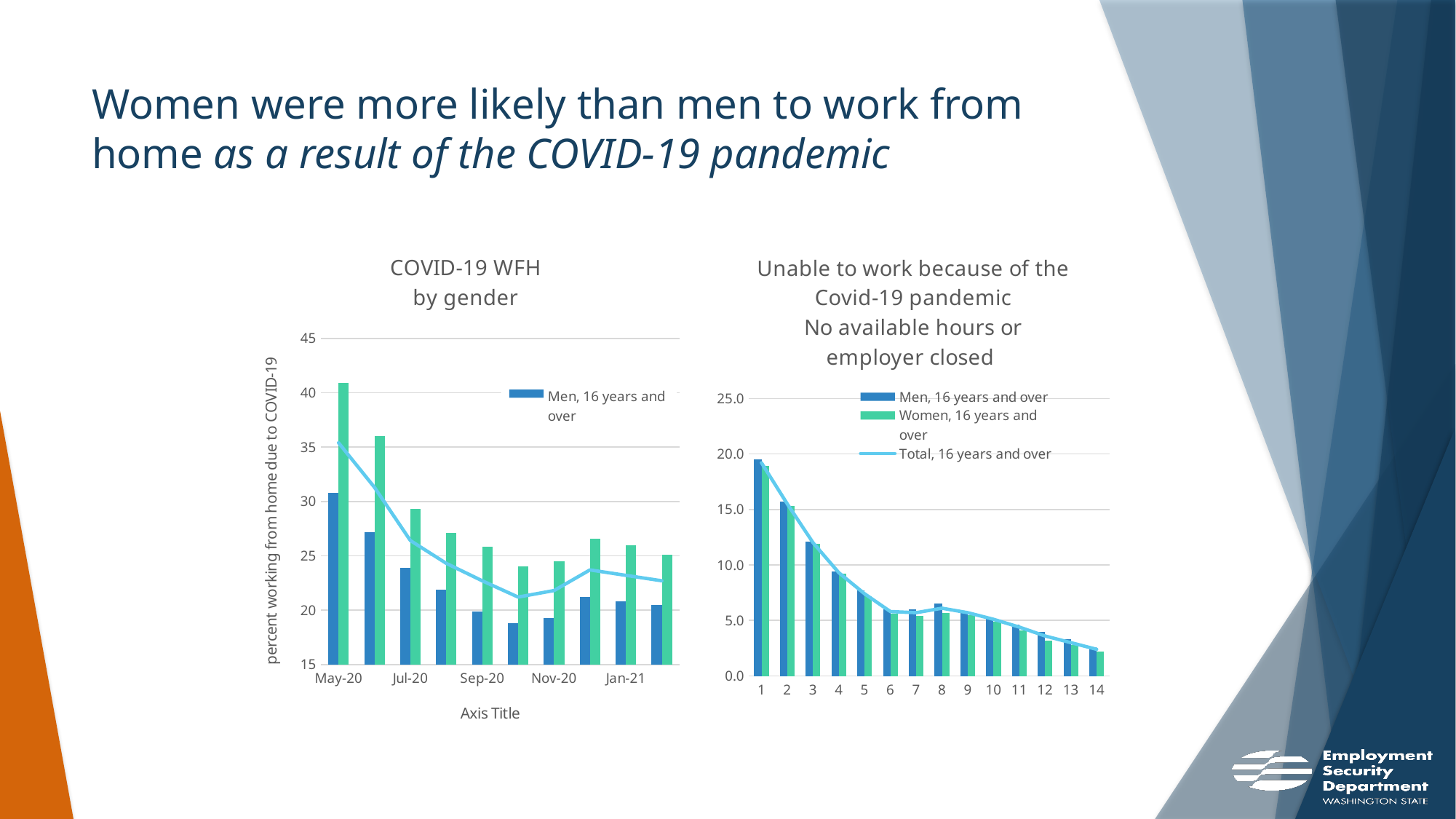
On the right chart (Unable to work because of the Covid-19 pandemic), how many series does the legend list? 3 On the left chart (COVID-19 WFH by gender), is the value for Women at May-20 greater or less than 40? greater On the left chart (COVID-19 WFH by gender), is the value for Men at May-20 greater or less than 30? greater On the left chart (COVID-19 WFH by gender), what is the y-axis title? percent working from home due to COVID-19 On the left chart (COVID-19 WFH by gender), which month has the highest value for Women? May-20 On the right chart (Unable to work because of the Covid-19 pandemic), is the value for Men at category 1 greater or less than 15.0? greater On the left chart (COVID-19 WFH by gender), at May-20, which is larger: the value for Men or the value for Women? Women On the right chart (Unable to work because of the Covid-19 pandemic), what kind of chart is used for the Men and Women series? bar chart On the left chart (COVID-19 WFH by gender), do the values for Women rise or fall from May-20 to Nov-20? fall On the right chart (Unable to work because of the Covid-19 pandemic), which category has the lowest value for Women? 14 On the right chart (Unable to work because of the Covid-19 pandemic), which category has the highest value for Men? 1 On the right chart (Unable to work because of the Covid-19 pandemic), how many categories are shown on the x axis? 14